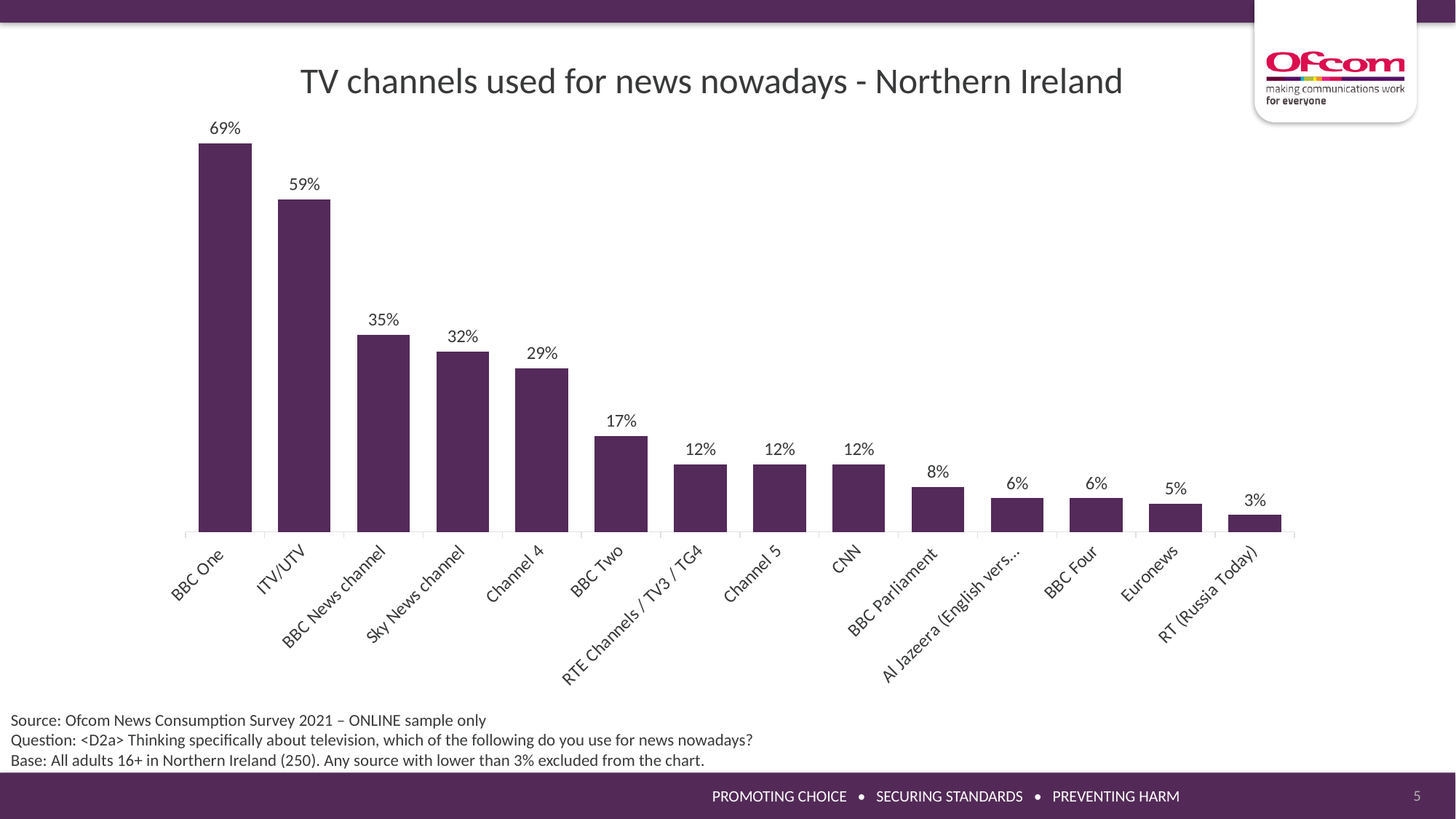
Which has a higher value, BBC Two or Channel 5? BBC Two What is the value shown for BBC Parliament? 8% What is the value shown for Sky News channel? 32% Do the values rise or fall moving from left to right along the x axis? Fall What is the difference between the values for BBC News channel and Channel 4? 6% Which has a higher value, Euronews or BBC Four? BBC Four What percentage of respondents use BBC One for news nowadays? 69% What kind of chart is shown on the slide? Bar chart How many TV channels are shown on the chart? 14 Which TV channel has the highest value on the chart? BBC One Which TV channel has the lowest value on the chart? RT (Russia Today) What is the difference between the values for BBC One and ITV/UTV? 10%